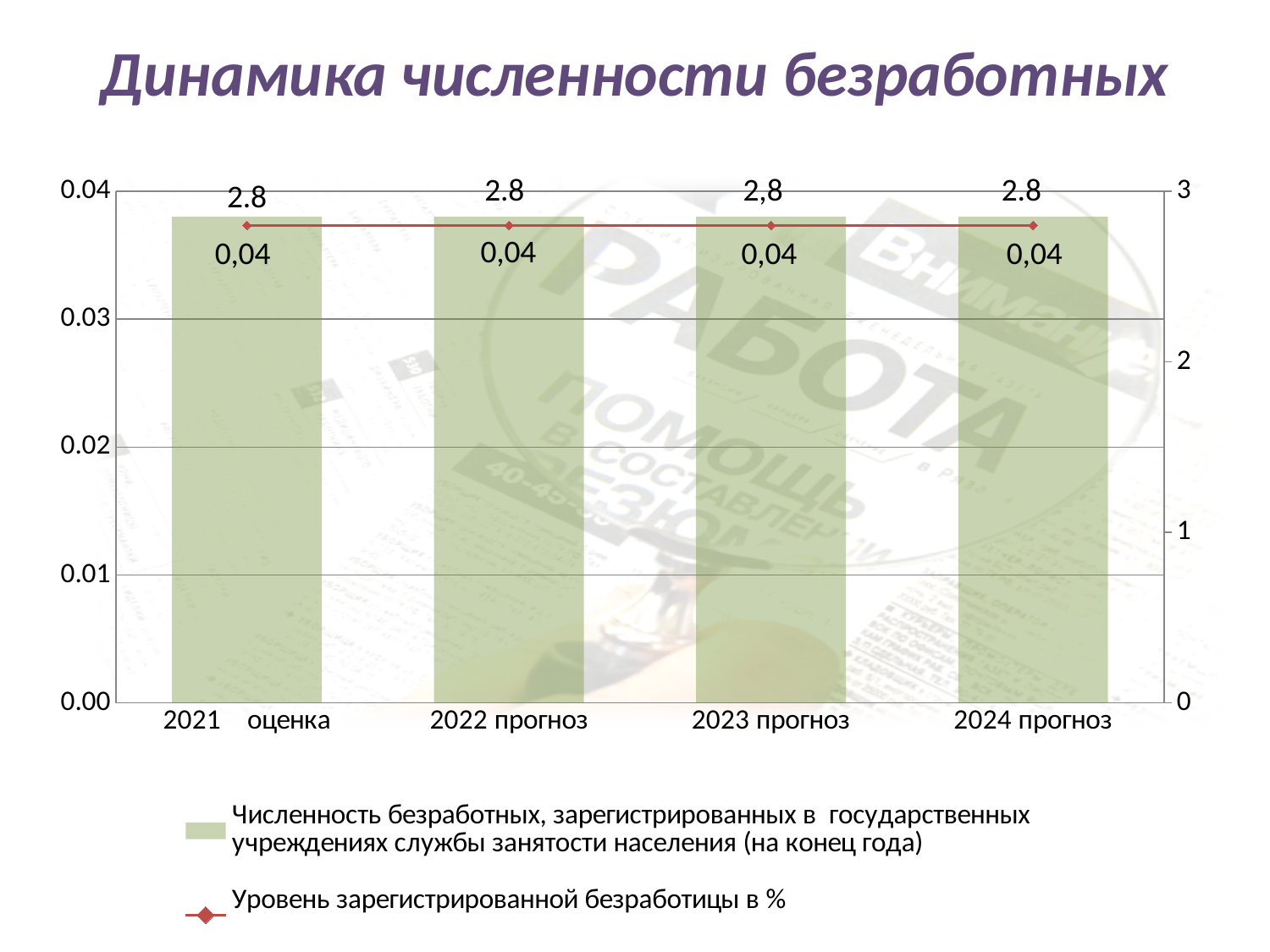
What is the value of the bar for 2022 прогноз? 0,04 What is the value of the line series for 2023 прогноз? 2.8 What is the difference between the bar values for 2021 оценка and 2024 прогноз? 0 How many categories are shown on the x axis? 4 What is the value of the line series (Уровень зарегистрированной безработицы в %) for 2024 прогноз? 2.8 What is the value of the bar for 2021 оценка? 0,04 What is the title of the chart? Динамика численности безработных Do the values of the line series rise, fall or stay flat from 2021 оценка to 2024 прогноз? stay flat What kind of chart is shown on the slide? a bar chart combined with a line chart What colour are the bars in the chart? green How many series does the legend list? 2 Is the bar value for 2023 прогноз greater or less than 0.03? greater